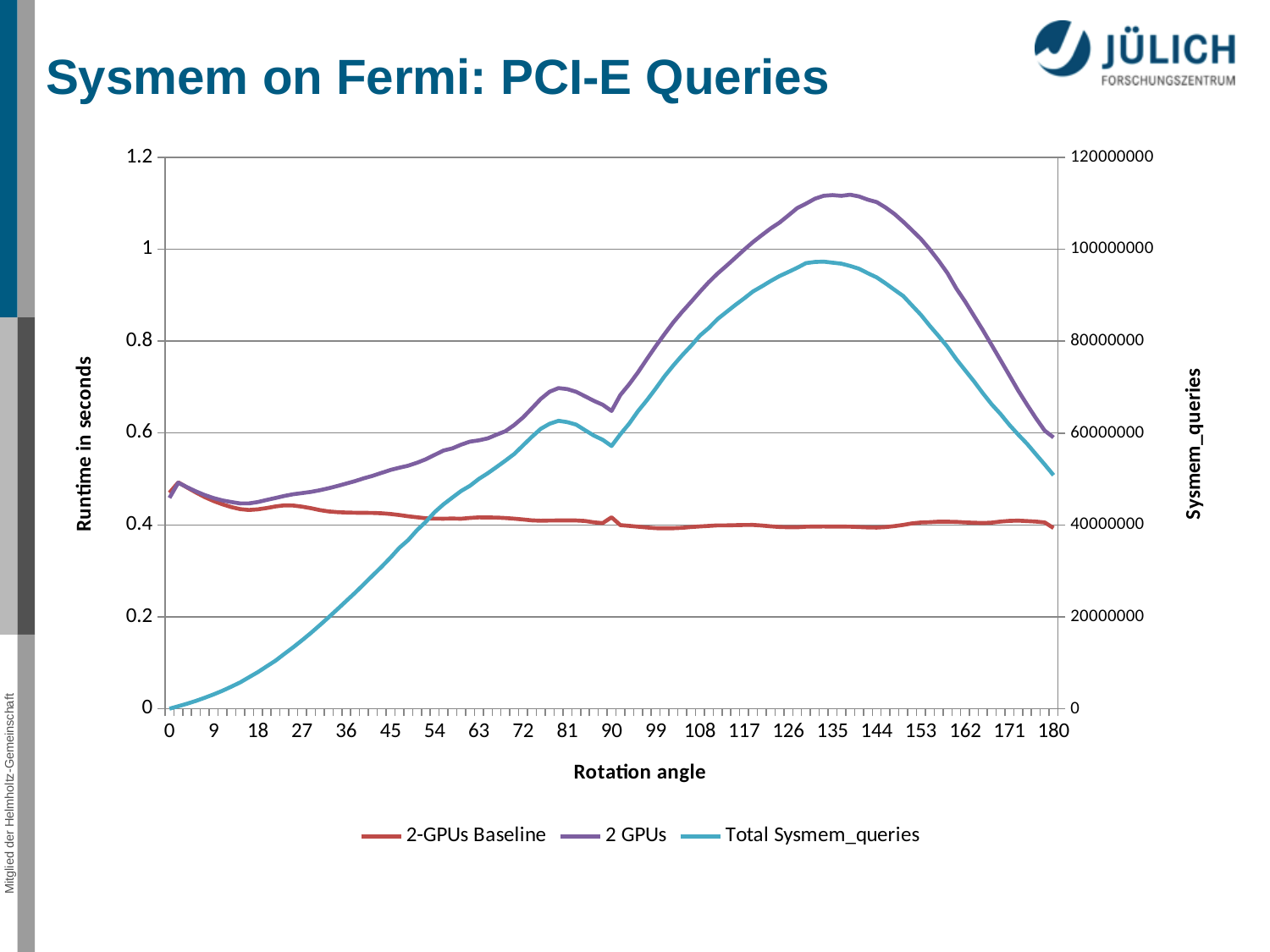
Is the value of the 2-GPUs Baseline series at rotation angle 90 greater or less than 0.6 on the left axis? less What kind of chart is shown on the slide? line chart Is the value of the 2 GPUs series at rotation angle 135 greater or less than 1 on the left axis? greater Is the value of the Total Sysmem_queries series at rotation angle 36 greater or less than 40000000 on the right axis? less At rotation angle 135, which series has the higher runtime: 2 GPUs or 2-GPUs Baseline? 2 GPUs How many series does the legend list? 3 What are the three series named in the legend? 2-GPUs Baseline, 2 GPUs, Total Sysmem_queries Does the 2 GPUs series rise or fall between rotation angle 135 and rotation angle 180? fall What is the title of the x axis? Rotation angle Does the Total Sysmem_queries series rise or fall between rotation angle 0 and rotation angle 135? rise